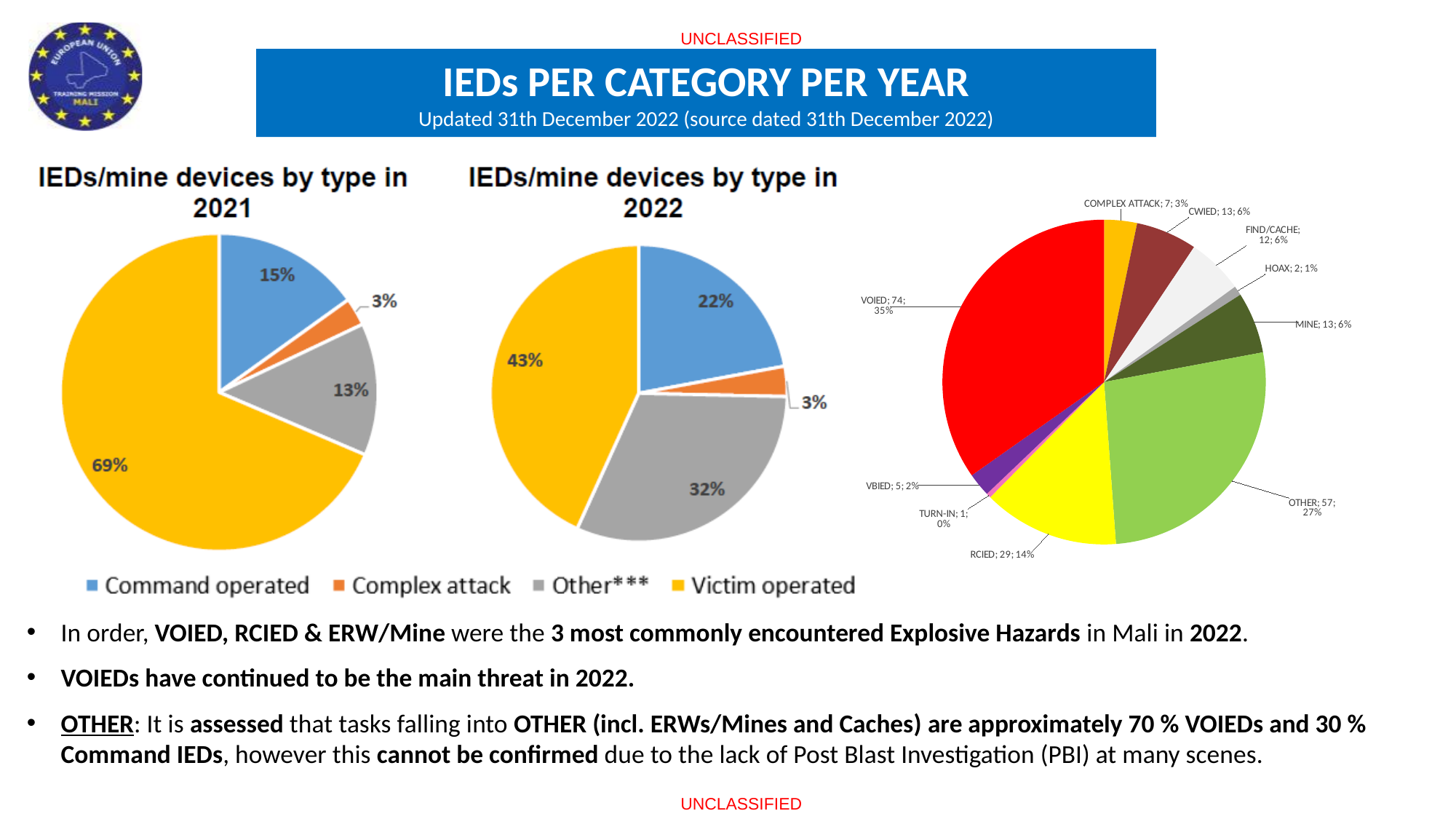
In the pie chart on the right of the slide, which category has the largest share? VOIED In the 'IEDs/mine devices by type in 2021' chart, what percentage is Complex attack? 3% In the pie chart on the right of the slide, what is the count for VOIED? 74 In the 'IEDs/mine devices by type in 2022' chart, what percentage is Other***? 32% In the pie chart on the right of the slide, which category has the smallest share? TURN-IN How many categories does the pie chart on the right of the slide show? 10 In the 'IEDs/mine devices by type in 2022' chart, which is larger: Command operated or Other***? Other*** In the 'IEDs/mine devices by type in 2022' chart, which category has the largest share? Victim operated How many entries does the shared legend below the 2021 and 2022 charts list? 4 By how many percentage points did the Victim operated share fall from the 2021 chart (69%) to the 2022 chart (43%)? 26 percentage points In the 'IEDs/mine devices by type in 2021' chart, what percentage is Victim operated? 69% What kind of chart is 'IEDs/mine devices by type in 2021'? Pie chart